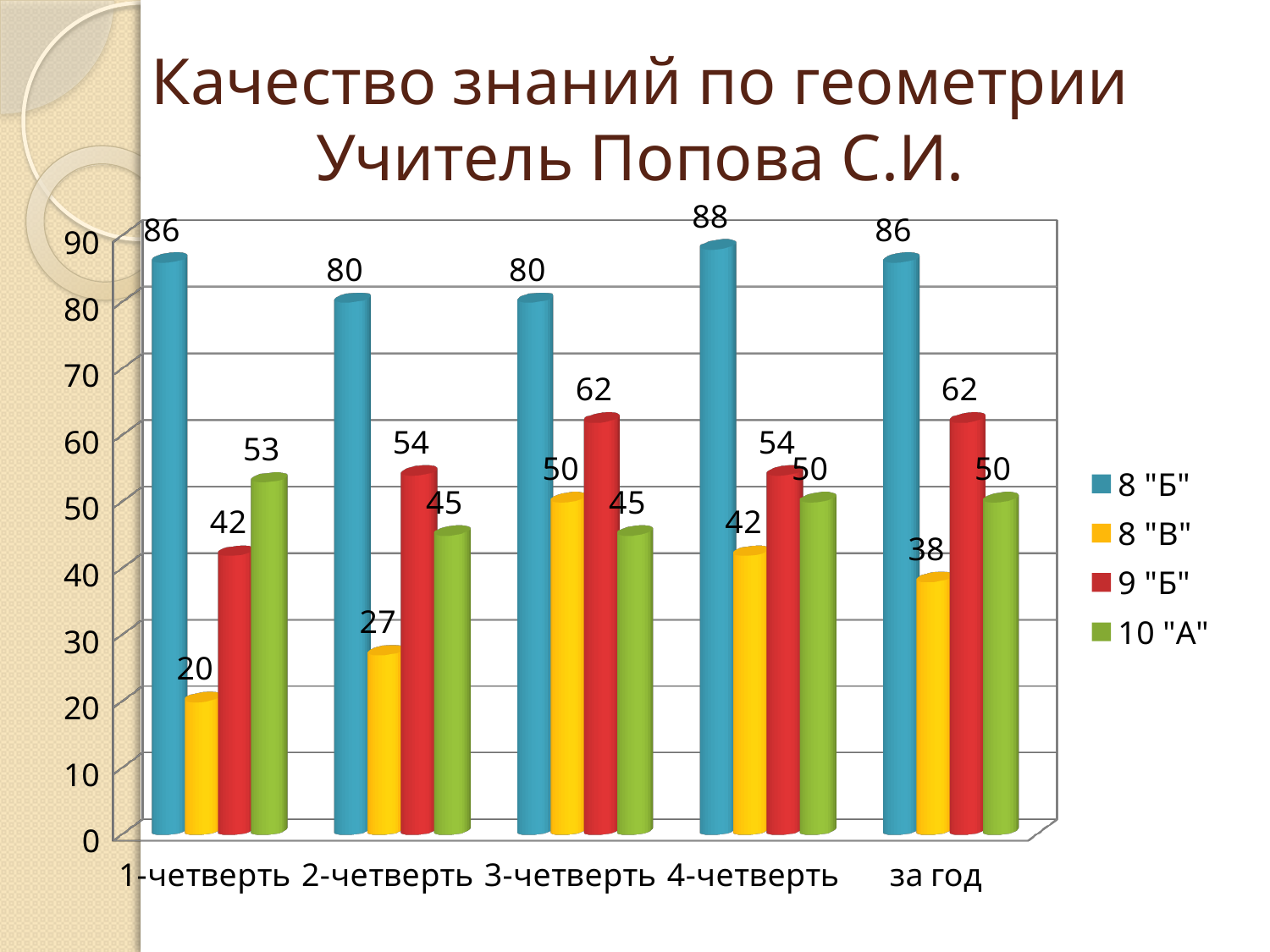
Which is larger in 2-четверть: 9 "Б" or 10 "А"? 9 "Б" What is the difference between the values for 9 "Б" and 8 "В" in 1-четверть? 22 What is the value for 8 "В" in 2-четверть? 27 What kind of chart is shown on the slide? Bar chart Which series is shown in yellow in the legend? 8 "В" What is the value for 9 "Б" in 3-четверть? 62 What is the value for 8 "Б" in 1-четверть? 86 In which category is the value for 8 "В" lowest? 1-четверть What is the value for 10 "А" за год? 50 How many series does the legend list? 4 How many categories are shown on the x axis? 5 In which category does 8 "Б" reach its highest value? 4-четверть